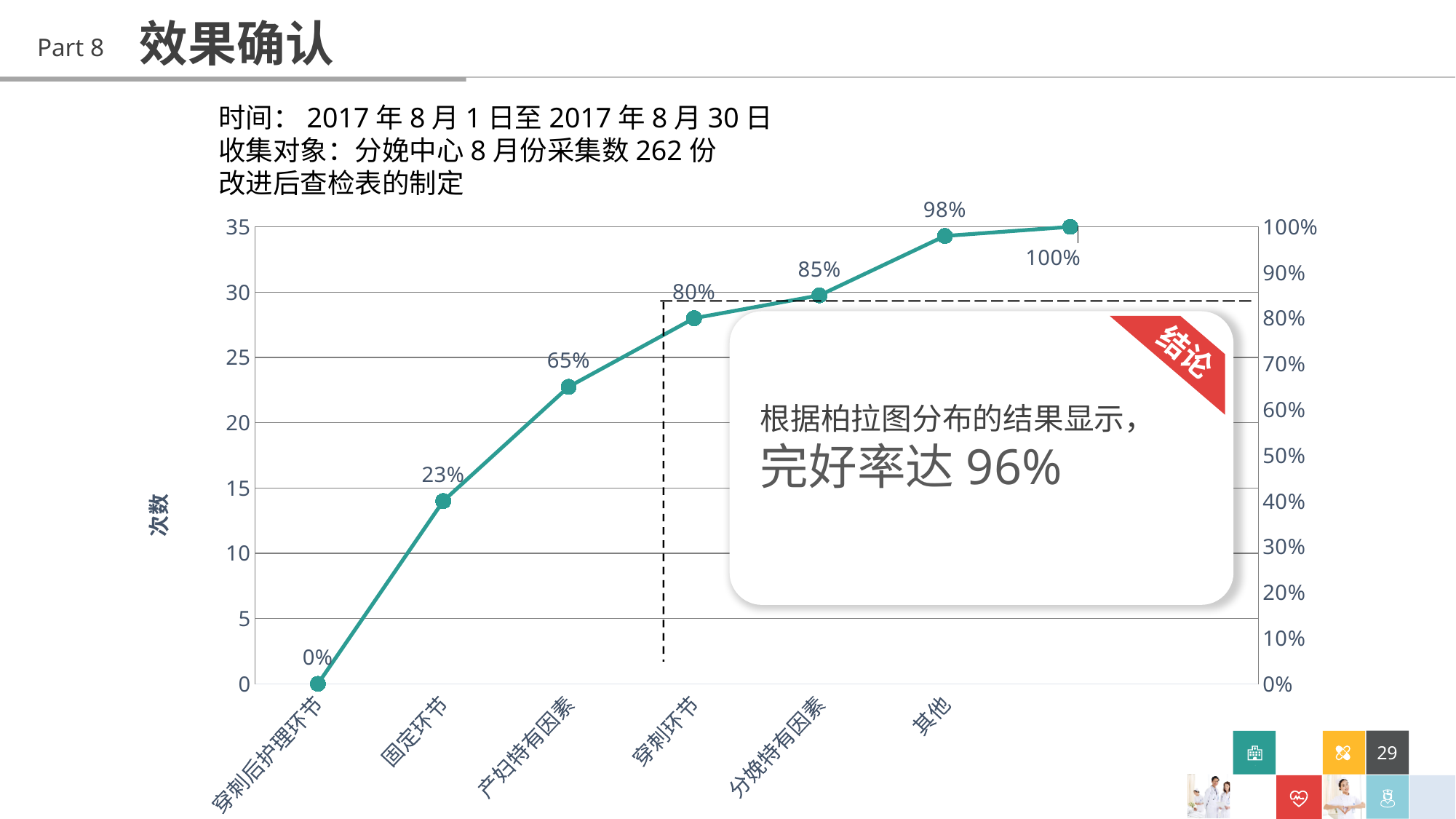
What is the cumulative percentage labelled at 穿刺环节? 80% Which has the larger percentage label, 穿刺环节 or 分娩特有因素? 分娩特有因素 Do the values on the line rise or fall from left to right along the x axis? rise What is the cumulative percentage labelled at 分娩特有因素? 85% What kind of chart is shown on the slide? line chart What is the cumulative percentage labelled at 产妇特有因素? 65% What is the cumulative percentage labelled at 其他? 98% What is the label of the left vertical axis? 次数 What is the cumulative percentage labelled at 固定环节? 23% What is the lowest percentage label shown on the line? 0% What is the highest percentage label shown on the line? 100% What is the difference between the percentage labels at 产妇特有因素 and 固定环节? 42%